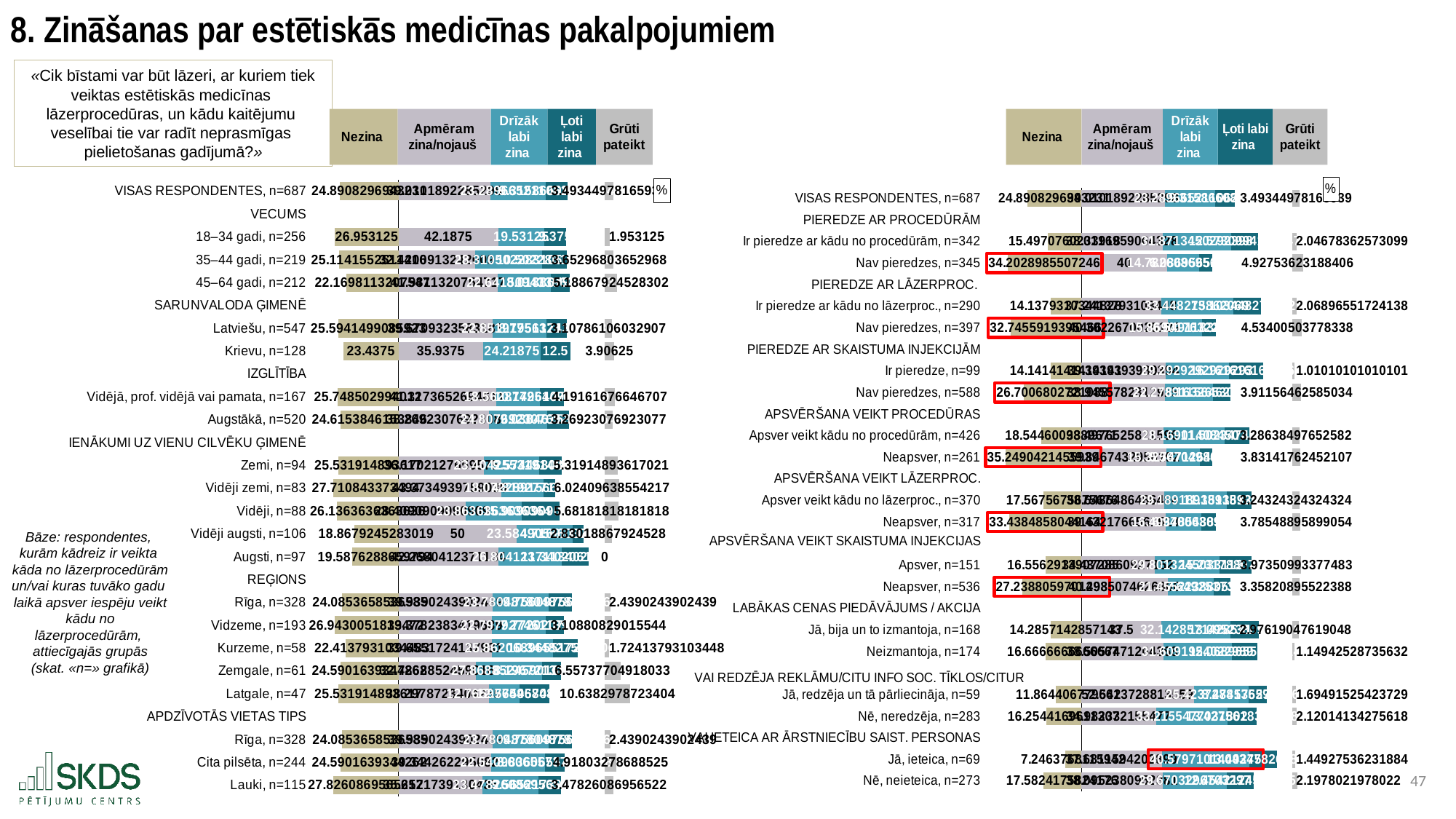
In the left chart, for Krievu, n=128, which is larger: Drīzāk labi zina or Ļoti labi zina? Drīzāk labi zina In the left chart, what is the Apmēram zina/nojauš value for Krievu, n=128? 35.9375 In the left chart, what is the Ļoti labi zina value for Krievu, n=128? 12.5 How many series does the legend of the left chart list? 5 In the left chart, what is the Apmēram zina/nojauš value for Vidēji augsti, n=106? 50 In the left chart, what is the Nezina value for Krievu, n=128? 23.4375 In the left chart, what is the Grūti pateikt value for Augsti, n=97? 0 In the left chart, what is the Grūti pateikt value for Krievu, n=128? 3.90625 In the right chart, what is the Nezina value for Nav pieredzes, n=345 (Pieredze ar procedūrām)? 34.2028985507246 In the right chart, what is the Apmēram zina/nojauš value for Jā, bija un to izmantoja, n=168? 37.5 In the right chart, what is the Nezina value for Neapsver, n=261 (Apsvēršana veikt procedūras)? 35.2490421455939 In the left chart, what is the difference between the Apmēram zina/nojauš and Nezina values for Krievu, n=128? 12.5